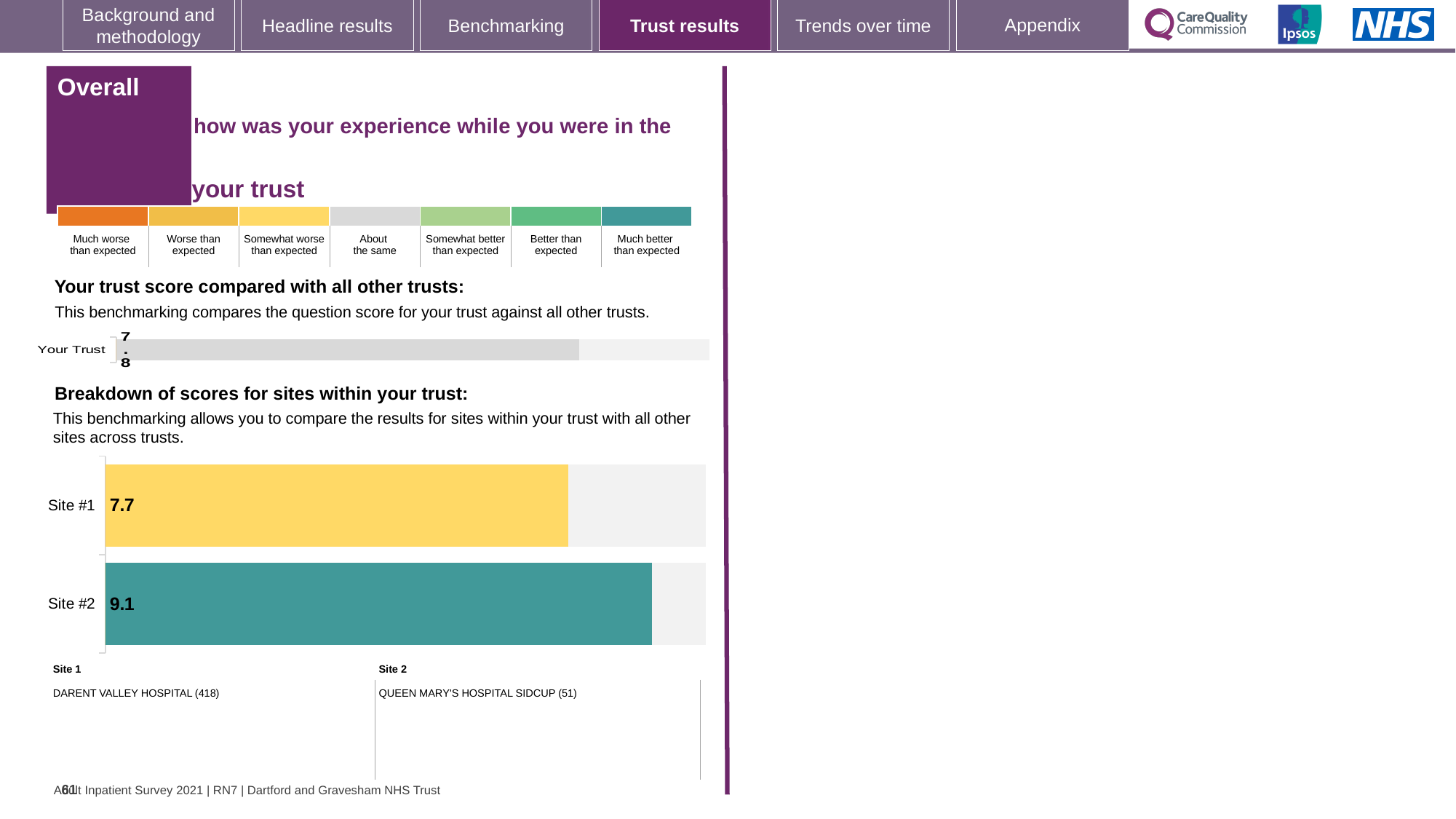
In the 'Breakdown of scores for sites within your trust' chart, what colour is the bar for Site #1? Yellow In the 'Breakdown of scores for sites within your trust' chart, is the score for Site #1 or Site #2 larger? Site #2 In the 'Breakdown of scores for sites within your trust' chart, what is the score for Site #2? 9.1 How many sites are shown in the 'Breakdown of scores for sites within your trust' chart? 2 In the 'Breakdown of scores for sites within your trust' chart, what colour is the bar for Site #2? Teal In the 'Breakdown of scores for sites within your trust' chart, what is the score for Site #1? 7.7 How many categories are plotted in the 'Your trust score compared with all other trusts' chart? 1 What kind of chart is the 'Breakdown of scores for sites within your trust' chart? Bar chart In the 'Breakdown of scores for sites within your trust' chart, which site has the lowest score? Site #1 In the 'Breakdown of scores for sites within your trust' chart, what is the difference between the scores for Site #2 and Site #1? 1.4 In the 'Breakdown of scores for sites within your trust' chart, which site has the highest score? Site #2 In the 'Your trust score compared with all other trusts' chart, what is the score for Your Trust? 7.8